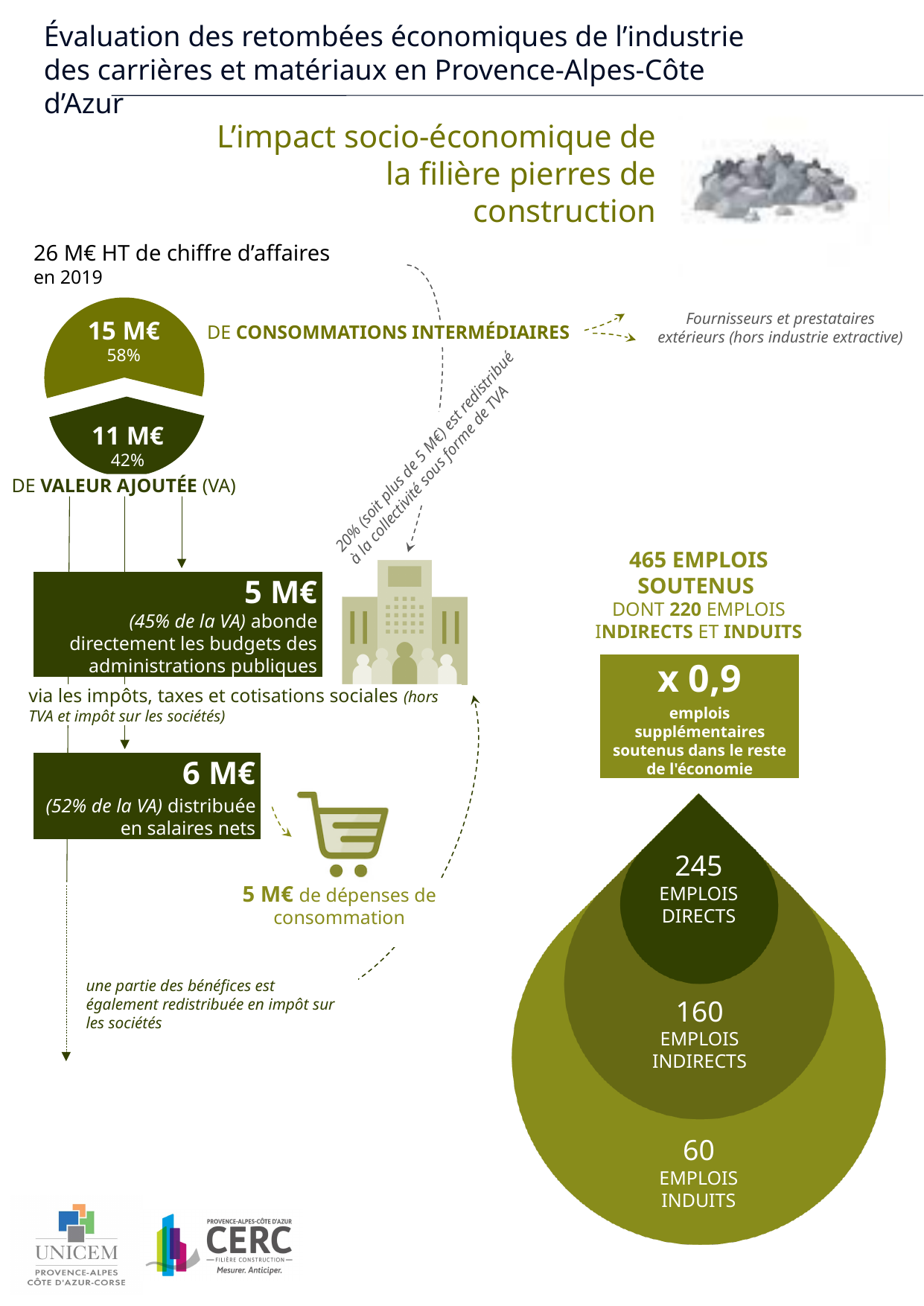
In the pie chart, what share of the turnover is valeur ajoutée? 42% In the nested circles chart of jobs, how many emplois directs are shown? 245 What kind of chart shows the split of the 26 M€ turnover into consommations intermédiaires and valeur ajoutée? pie chart In the nested circles chart of jobs, how many emplois induits are shown? 60 In the pie chart, what is the value for consommations intermédiaires? 15 M€ In the pie chart, which slice is larger: consommations intermédiaires or valeur ajoutée? consommations intermédiaires In the nested circles chart of jobs, which category has the lowest number of jobs? emplois induits In the pie chart, what is the value for valeur ajoutée (VA)? 11 M€ In the pie chart, what share of the turnover is consommations intermédiaires? 58% In the pie chart, how many slices are shown? 2 In the pie chart, what is the difference between consommations intermédiaires and valeur ajoutée? 4 M€ In the nested circles chart of jobs, what is the difference between emplois directs and emplois indirects? 85